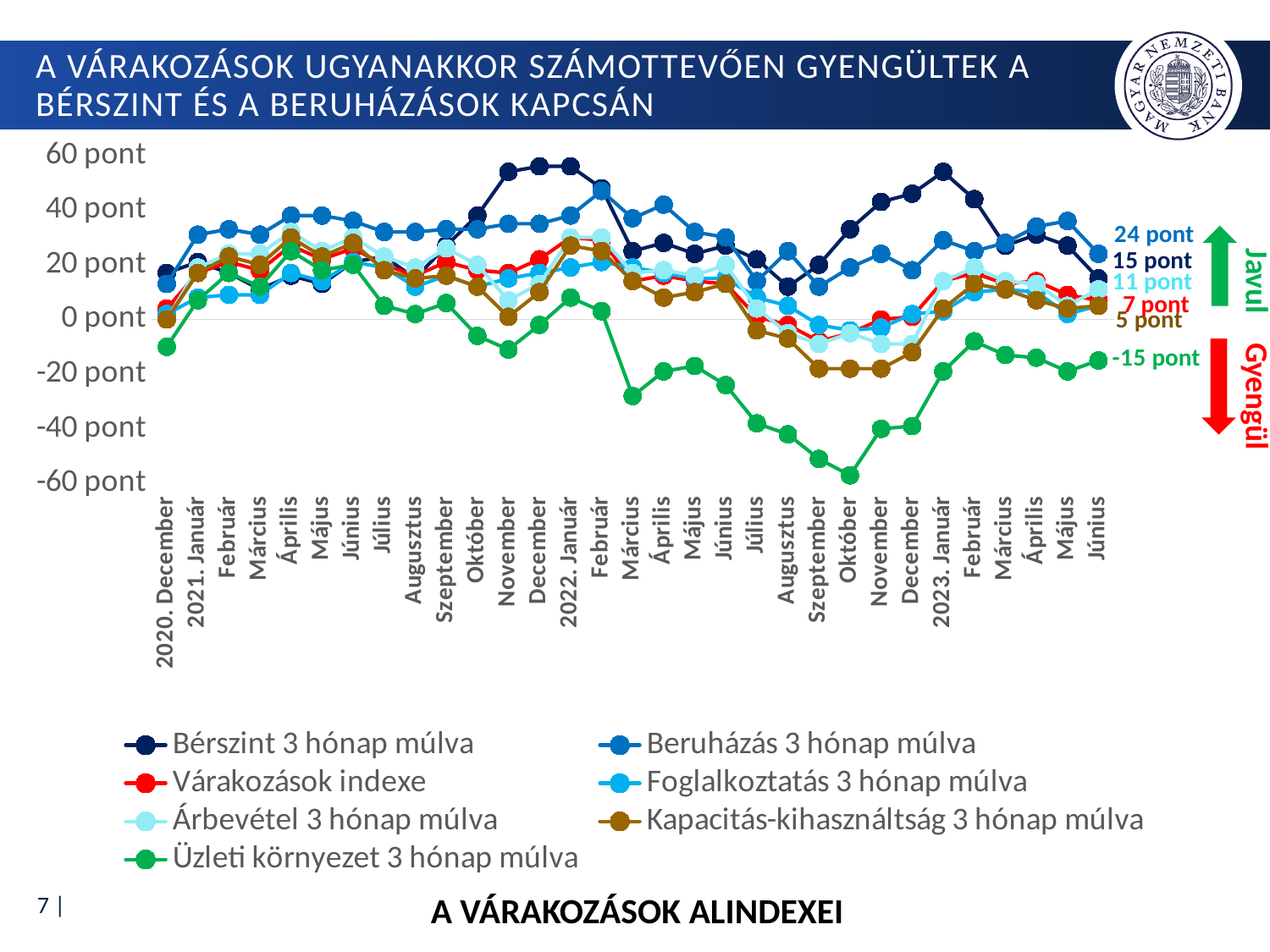
What is the value of Üzleti környezet 3 hónap múlva at the end of the series (2023 Június)? -15 pont Which series has the lowest value at 2023 Június? Üzleti környezet 3 hónap múlva Is the value of Bérszint 3 hónap múlva in 2021 December greater or less than 40 pont? greater Is the value of Üzleti környezet 3 hónap múlva in 2022 Október greater or less than -40 pont? less What is the value of Várakozások indexe at the end of the series (2023 Június)? 7 pont At 2023 Június, which is larger: Beruházás 3 hónap múlva or Bérszint 3 hónap múlva? Beruházás 3 hónap múlva How many series does the legend list? 7 What is the title shown below the chart? A várakozások alindexei What kind of chart is shown on the slide? line chart What is the value of Bérszint 3 hónap múlva at the end of the series (2023 Június)? 15 pont What is the difference between the end values of Beruházás 3 hónap múlva and Bérszint 3 hónap múlva? 9 pont What is the value of Beruházás 3 hónap múlva at the end of the series (2023 Június)? 24 pont